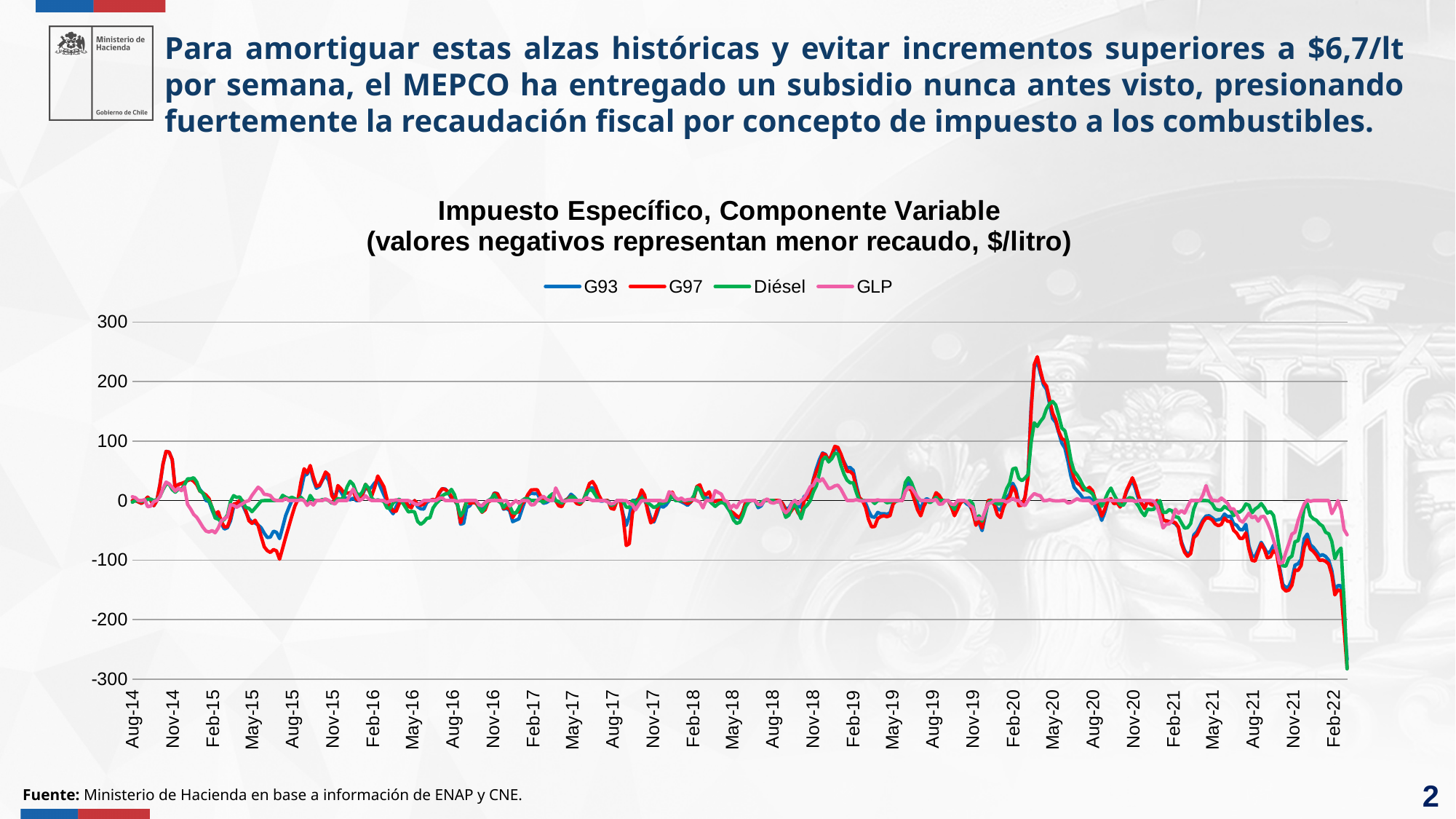
Which colour is used for the GLP series? Pink What is the title of the chart? Impuesto Específico, Componente Variable (valores negativos representan menor recaudo, $/litro) Is the peak value of GLP around Nov-18 greater or less than 100? less What kind of chart is shown on the slide? Line chart Which series reaches the highest value on the chart? G97 Around Mar-20, which series has the larger value, G97 or GLP? G97 Around Nov-18, which series has the larger value, G93 or GLP? G93 Is the value of G97 around Aug-17 greater or less than -50? less Is the lowest value of Diésel near Feb-22 greater or less than -200? less How many series does the legend list? 4